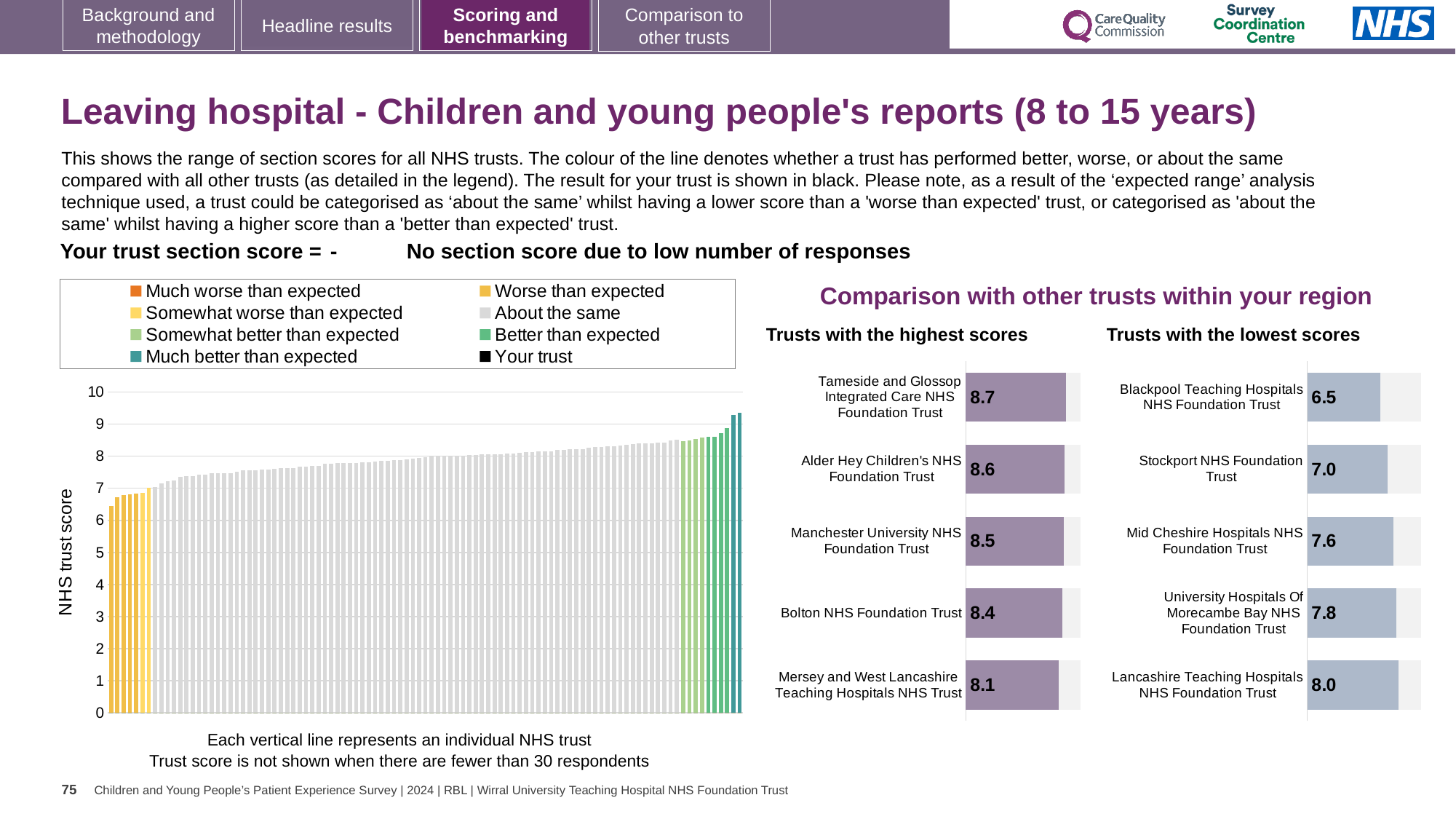
In the large chart on the left, do the NHS trust scores rise or fall from left to right? Rise In the 'Trusts with the highest scores' chart, what is the difference between the scores of Tameside and Glossop Integrated Care NHS Foundation Trust and Mersey and West Lancashire Teaching Hospitals NHS Trust? 0.6 In the 'Trusts with the lowest scores' chart, what is the difference between the scores of Stockport NHS Foundation Trust and Blackpool Teaching Hospitals NHS Foundation Trust? 0.5 In the 'Trusts with the lowest scores' chart, what is the score for Blackpool Teaching Hospitals NHS Foundation Trust? 6.5 What type of chart is the large chart on the left showing NHS trust scores? Bar chart Which has a higher score: Bolton NHS Foundation Trust in the highest scores chart or University Hospitals Of Morecambe Bay NHS Foundation Trust in the lowest scores chart? Bolton NHS Foundation Trust How many entries does the legend above the large chart on the left list? 8 In the 'Trusts with the lowest scores' chart, which trust has the highest score shown? Lancashire Teaching Hospitals NHS Foundation Trust In the 'Trusts with the highest scores' chart, which trust has the lowest score shown? Mersey and West Lancashire Teaching Hospitals NHS Trust How many trusts are listed in the 'Trusts with the lowest scores' chart? 5 In the 'Trusts with the highest scores' chart, what is the score for Tameside and Glossop Integrated Care NHS Foundation Trust? 8.7 In the large chart on the left, is the value of the leftmost bar greater or less than 7? less